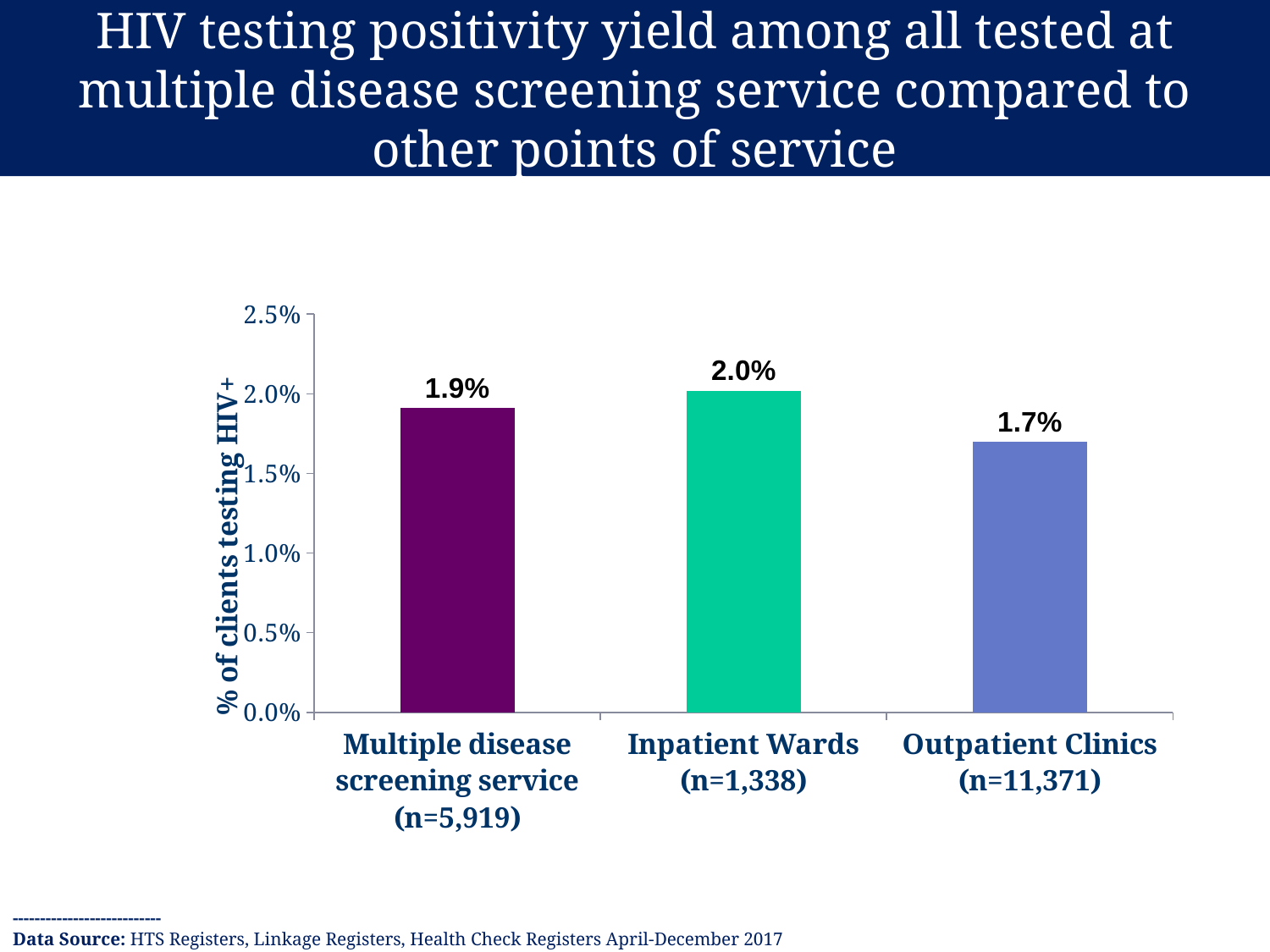
Which point of service has the lowest HIV positivity yield? Outpatient Clinics What is the difference in positivity yield between the Multiple disease screening service and Outpatient Clinics? 0.2% What is the HIV positivity yield for the Multiple disease screening service? 1.9% What is the difference in positivity yield between Inpatient Wards and Outpatient Clinics? 0.3% What is the HIV positivity yield for Outpatient Clinics? 1.7% What is the label of the vertical axis? % of clients testing HIV+ What is the HIV positivity yield for Inpatient Wards? 2.0% Which has a higher positivity yield, the Multiple disease screening service or Outpatient Clinics? Multiple disease screening service How many points of service are shown in the chart? 3 Is the value for Outpatient Clinics greater or less than 2.0%? less Which point of service has the highest HIV positivity yield? Inpatient Wards What kind of chart is shown on the slide? Bar chart